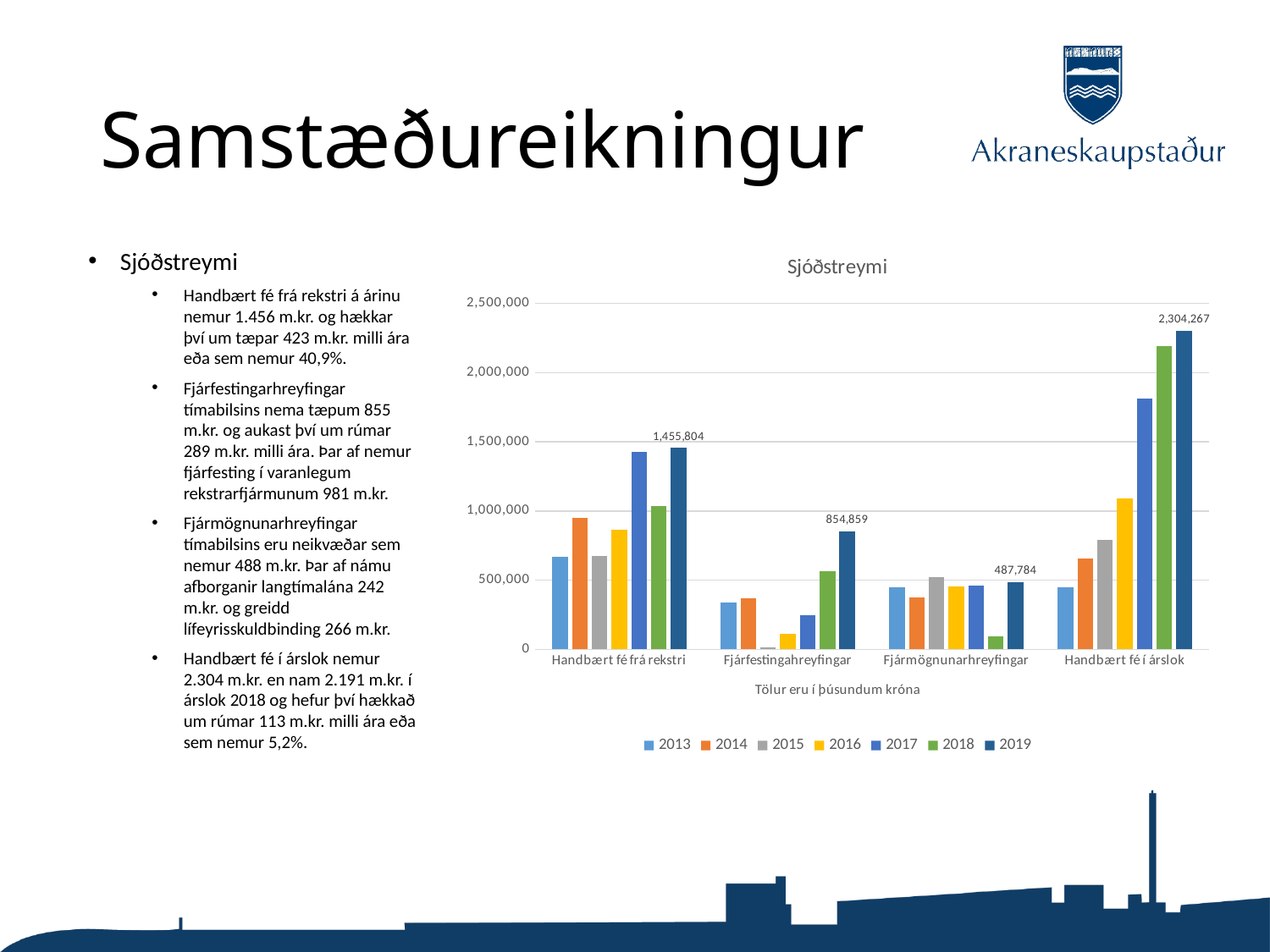
In the Sjóðstreymi chart, which is larger in 2019: Handbært fé frá rekstri or Fjárfestingahreyfingar? Handbært fé frá rekstri How many series does the legend of the Sjóðstreymi chart list? 7 In the Sjóðstreymi chart, which category has the highest 2019 value? Handbært fé í árslok In the Sjóðstreymi chart, which category has the lowest 2019 value? Fjármögnunarhreyfingar In the Sjóðstreymi chart, what is the difference between the 2019 values for Handbært fé í árslok and Handbært fé frá rekstri? 848,463 In the Sjóðstreymi chart, is the 2013 value for Handbært fé frá rekstri greater or less than 1,000,000? less In the Sjóðstreymi chart, is the 2018 value for Handbært fé í árslok greater or less than 2,000,000? greater In the Sjóðstreymi chart, do the values for Handbært fé í árslok rise or fall from 2013 to 2019? rise How many categories are shown on the x axis of the Sjóðstreymi chart? 4 In the Sjóðstreymi chart, what is the 2019 value for Handbært fé í árslok? 2,304,267 In the Sjóðstreymi chart, what is the 2019 value for Handbært fé frá rekstri? 1,455,804 In the Sjóðstreymi chart, what is the 2019 value for Fjármögnunarhreyfingar? 487,784